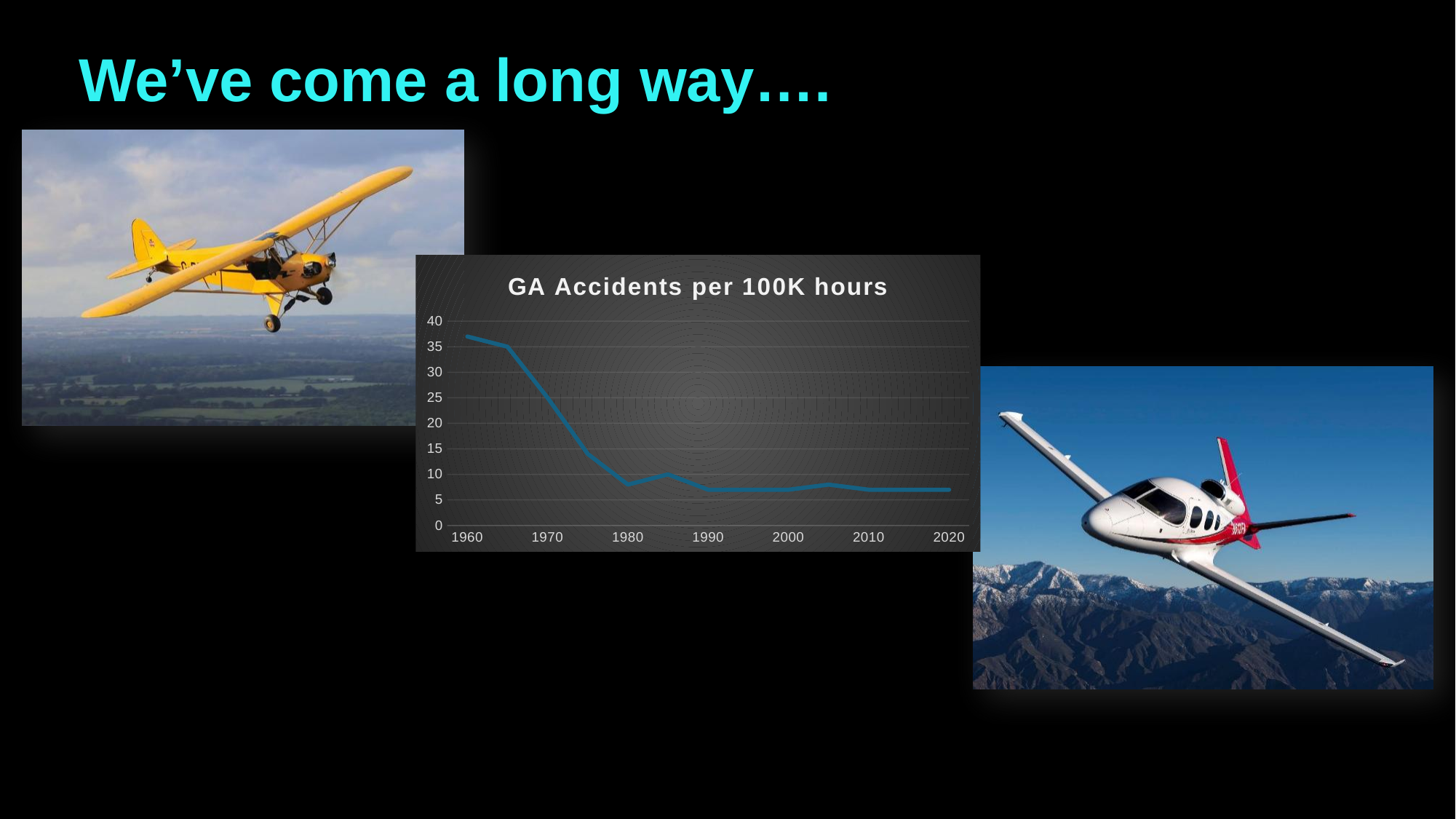
Which year on the x axis has the highest value in the chart? 1960 Is the value for 1990 greater or less than 15? less Do the values in the chart generally rise or fall from 1960 to 2020? fall Which is larger, the value for 1960 or the value for 2020? 1960 Which is larger, the value for 1970 or the value for 1980? 1970 Is the value for 1960 greater or less than 30? greater Is the value for 1980 greater or less than 10? less What is the title of the chart? GA Accidents per 100K hours What is the highest value shown on the y axis of the chart? 40 What kind of chart is shown on the slide? line chart